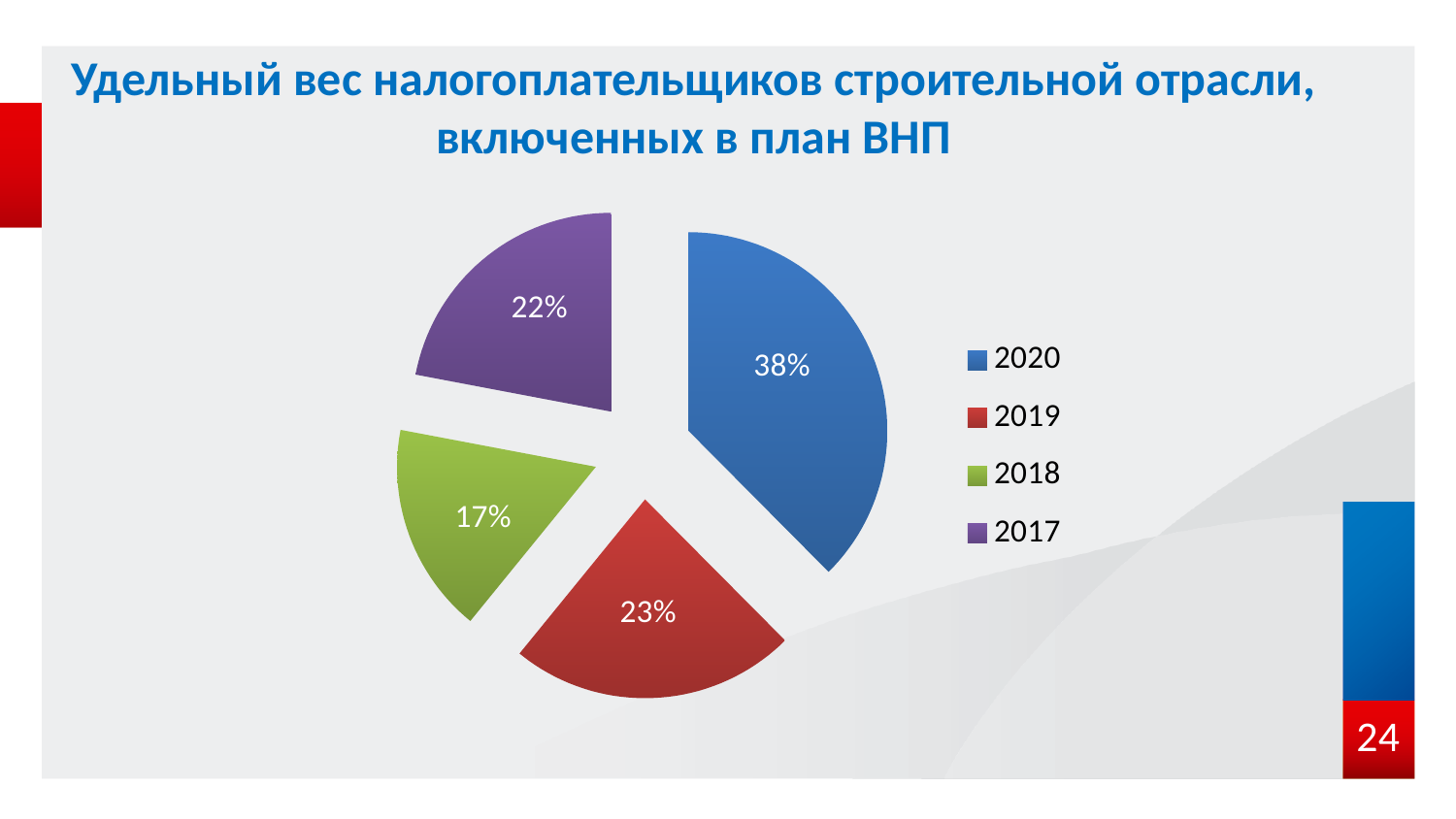
Which year has the largest slice of the pie? 2020 What is the value shown for 2018? 17% How many slices does the pie chart have? 4 What is the difference between the values for 2020 and 2018? 21% What share of the pie does 2020 have? 38% What is the value shown for 2017? 22% What kind of chart is shown on the slide? pie chart What colour is the slice for 2018? green Which year has the smallest slice of the pie? 2018 What is the value shown for 2019? 23% What is the difference between the values for 2019 and 2017? 1% Which is larger, the value for 2020 or the value for 2019? 2020